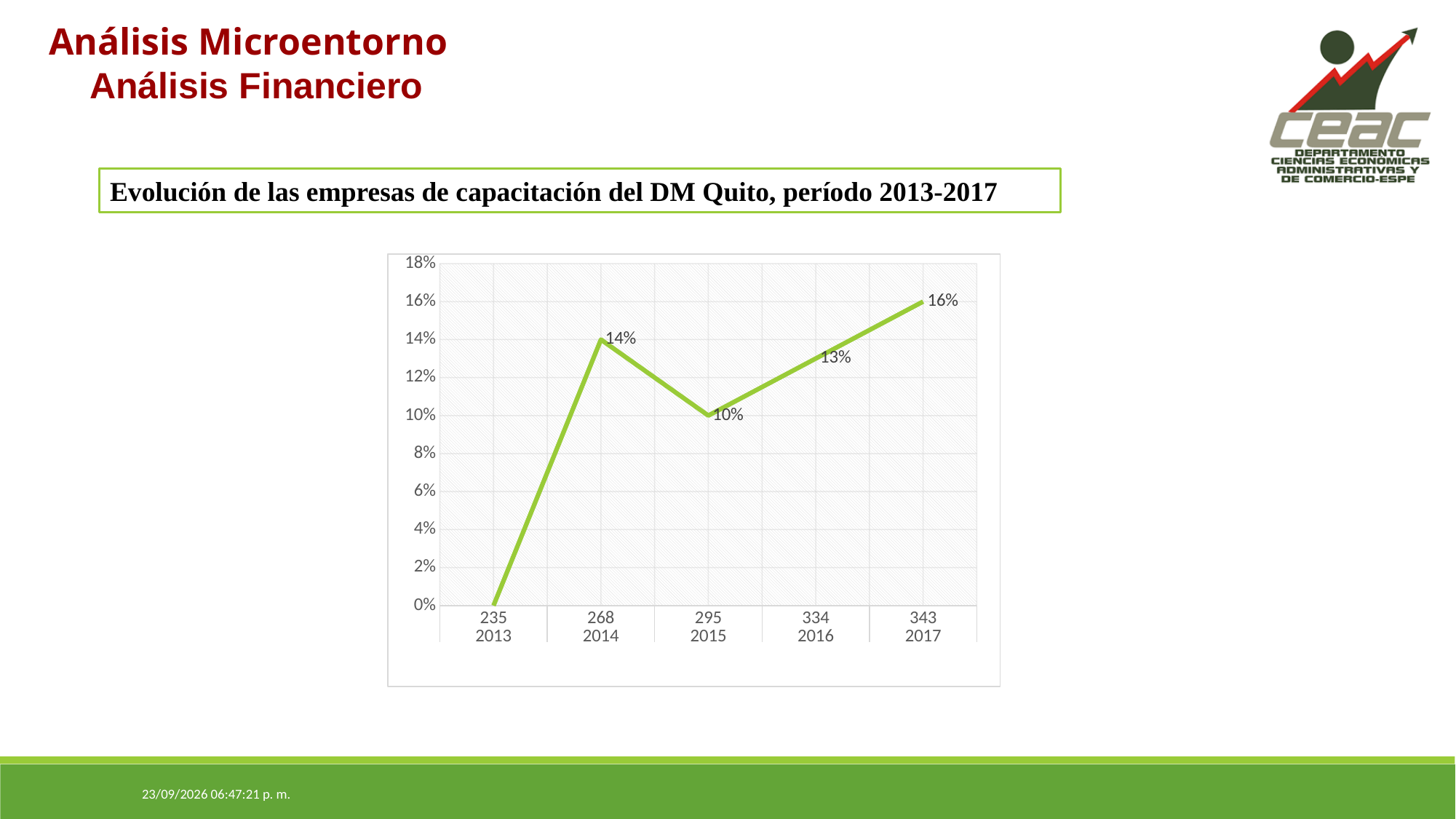
What kind of chart is shown on the slide? line chart What number of companies is shown on the x axis for 2016? 334 Is the value for 2013 greater or less than 2%? less Which is larger, the value for 2014 or the value for 2016? 2014 What is the value for 2014? 14% Which year has the highest value? 2017 What is the value for 2015? 10% What is the difference between the values for 2017 and 2015? 6% How many years are plotted on the x axis? 5 What is the value for 2017? 16% Which year has the lowest value? 2013 What is the value for 2016? 13%